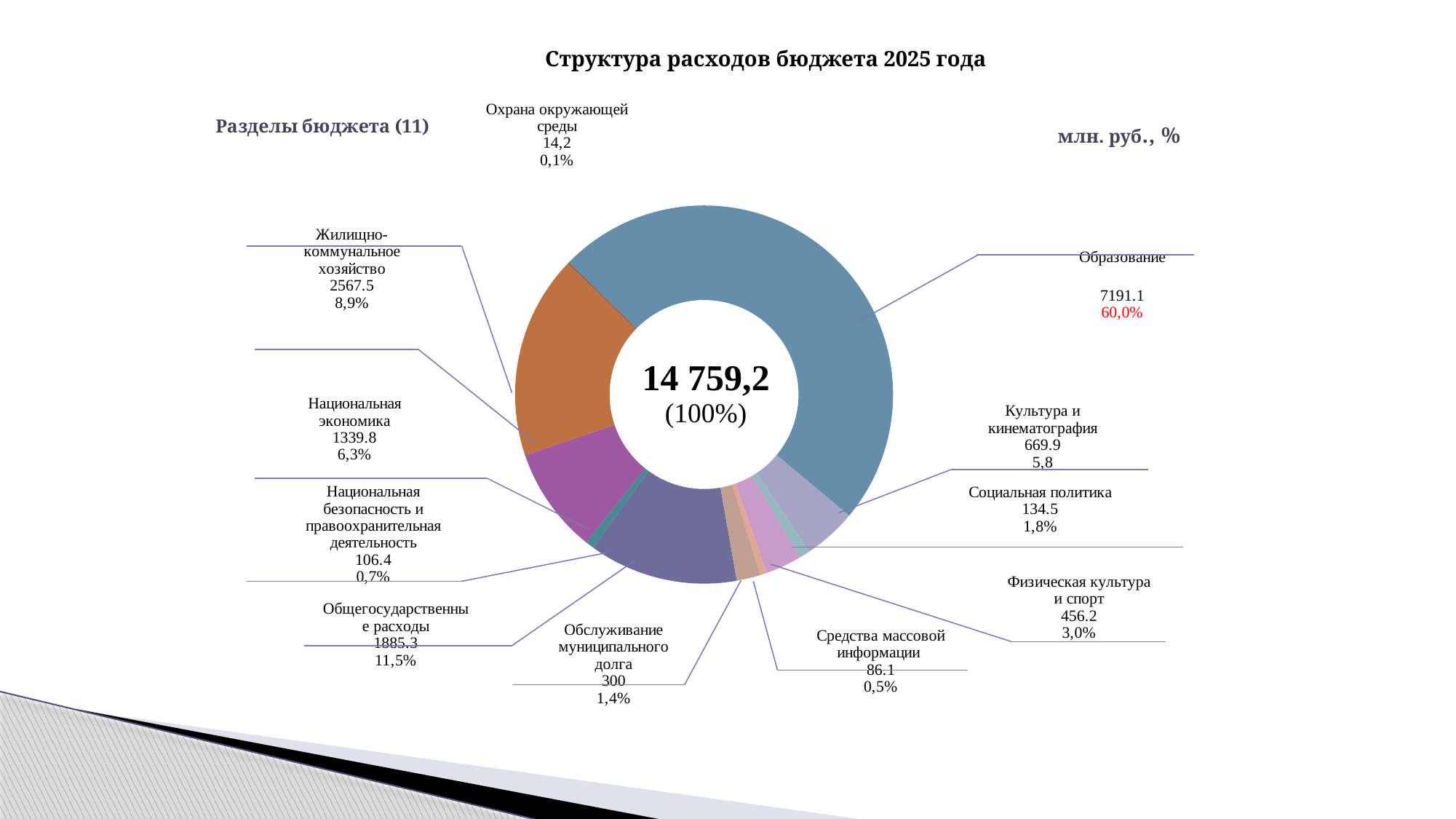
What is the title of the chart on the slide? Структура расходов бюджета 2025 года What share of the budget expenditures does Образование account for? 60,0% Which category has the largest value? Образование What kind of chart is shown on the slide? Pie (donut) chart What is the difference between the values for Общегосударственные расходы and Жилищно-коммунальное хозяйство? 682.2 What percentage share is shown for Общегосударственные расходы? 11,5% What is the value for Образование in млн. руб.? 7191.1 Which category has the smallest value? Охрана окружающей среды How many budget sections (categories) does the chart show? 11 What is the total shown in the centre of the chart? 14 759,2 Which is larger: Национальная экономика or Физическая культура и спорт? Национальная экономика What is the value for Жилищно-коммунальное хозяйство? 2567.5